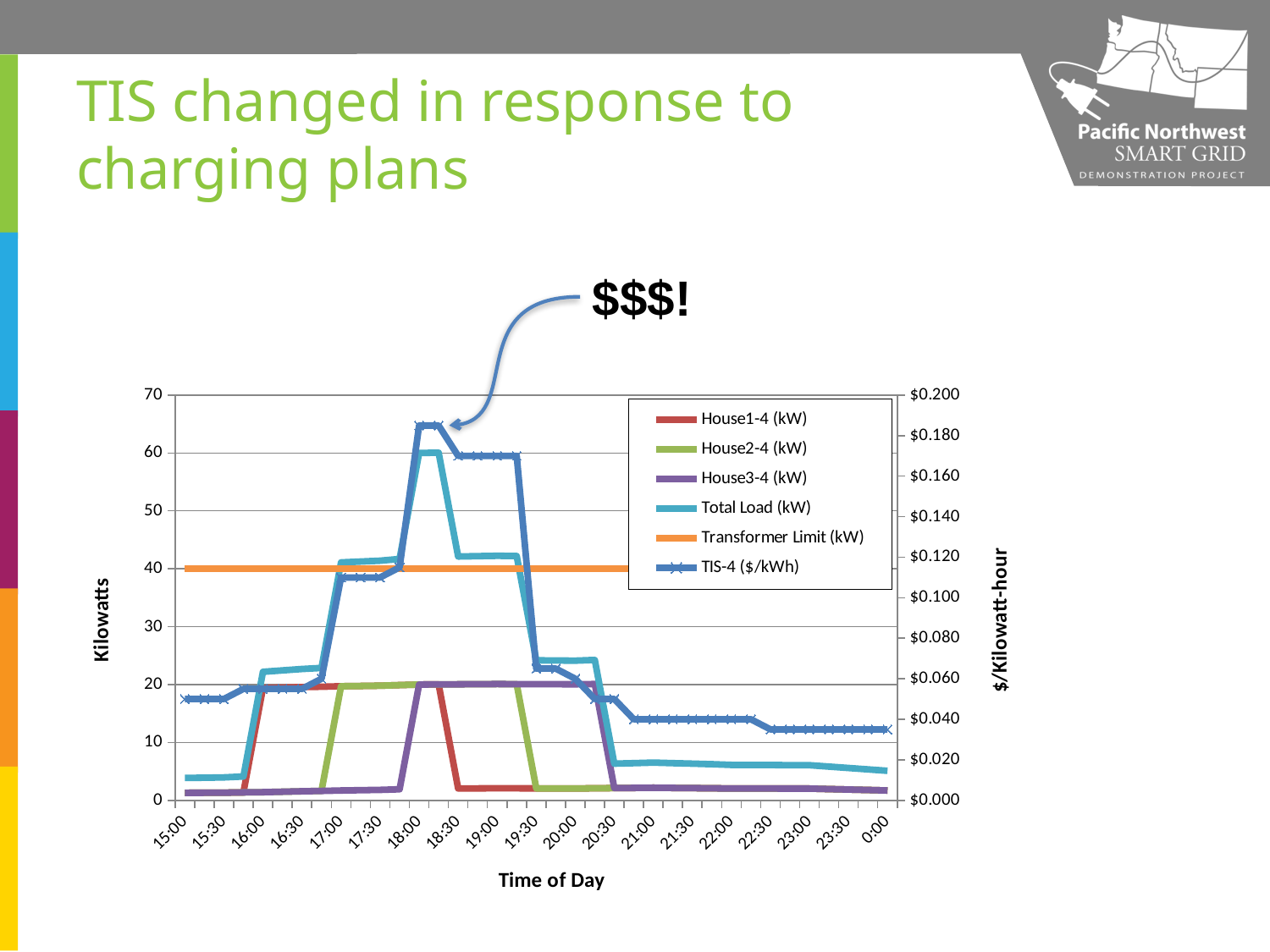
How many time labels are shown on the horizontal axis? 19 How many series does the chart legend list? 6 Is the Total Load (kW) value at 18:00 greater or less than 50? greater What is the label of the horizontal axis? Time of Day What kind of chart is shown on the slide? line chart Is the TIS-4 ($/kWh) value at 18:00 greater or less than $0.160? greater What is the label of the left vertical axis? Kilowatts Is the TIS-4 ($/kWh) value at 23:00 greater or less than $0.060? less At 18:00, which is larger: Total Load (kW) or Transformer Limit (kW)? Total Load (kW) What is the value of the Transformer Limit (kW) series? 40 Does the TIS-4 ($/kWh) series rise or fall from 19:30 to 0:00? fall